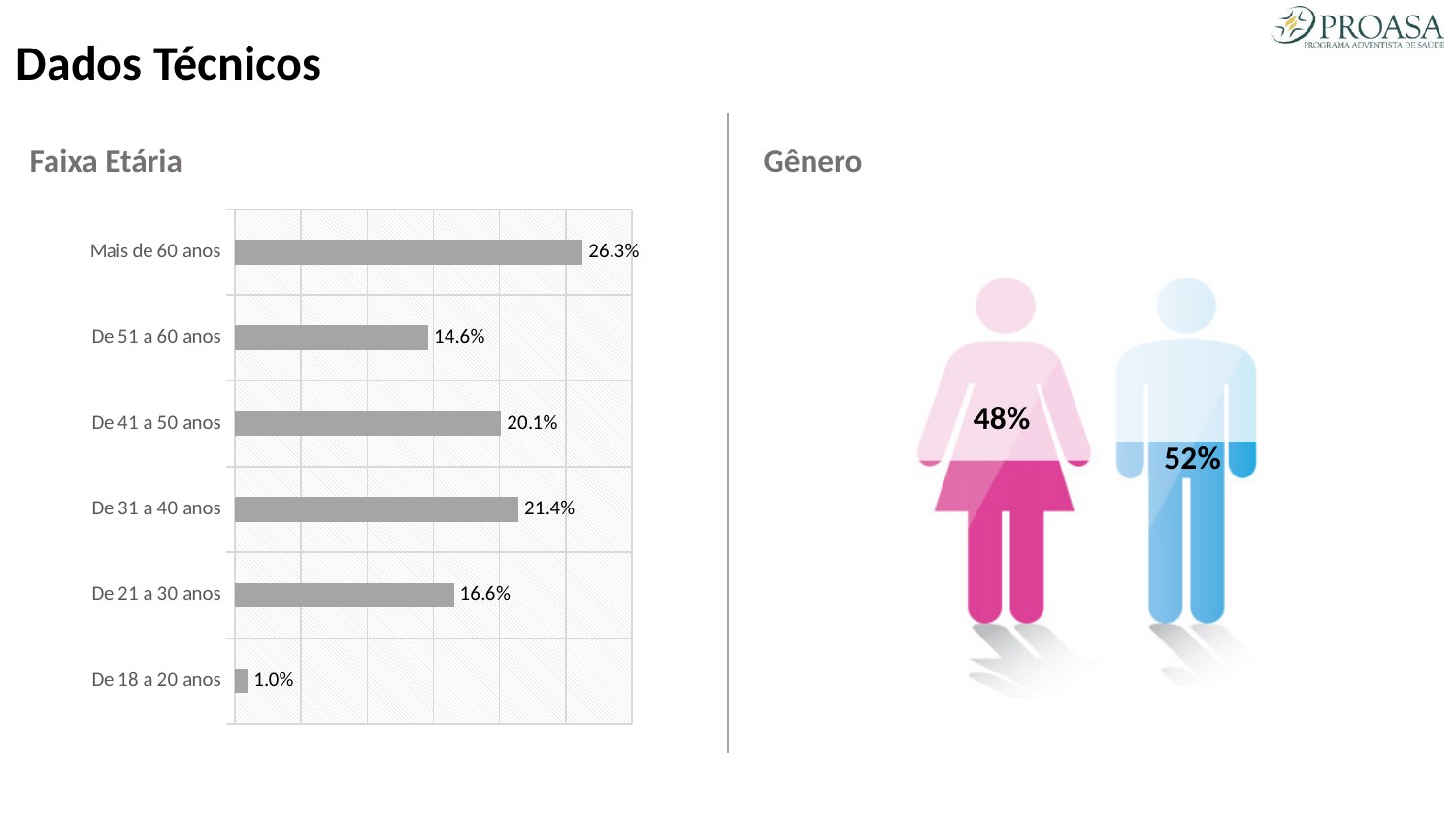
What kind of chart is the Faixa Etária chart? Bar chart In the Gênero graphic, what percentage is shown for the female figure? 48% In the Faixa Etária chart, what is the value for De 18 a 20 anos? 1.0% In the Faixa Etária chart, what is the value for De 51 a 60 anos? 14.6% How many age groups are shown in the Faixa Etária chart? 6 In the Faixa Etária chart, which age group has the lowest value? De 18 a 20 anos In the Faixa Etária chart, what is the difference between the values for Mais de 60 anos and De 51 a 60 anos? 11.7% In the Faixa Etária chart, what is the difference between the values for De 31 a 40 anos and De 41 a 50 anos? 1.3% In the Faixa Etária chart, which age group has the highest value? Mais de 60 anos In the Faixa Etária chart, what is the value for De 31 a 40 anos? 21.4% In the Faixa Etária chart, which is larger: the value for De 21 a 30 anos or De 51 a 60 anos? De 21 a 30 anos In the Faixa Etária chart, what is the value for Mais de 60 anos? 26.3%